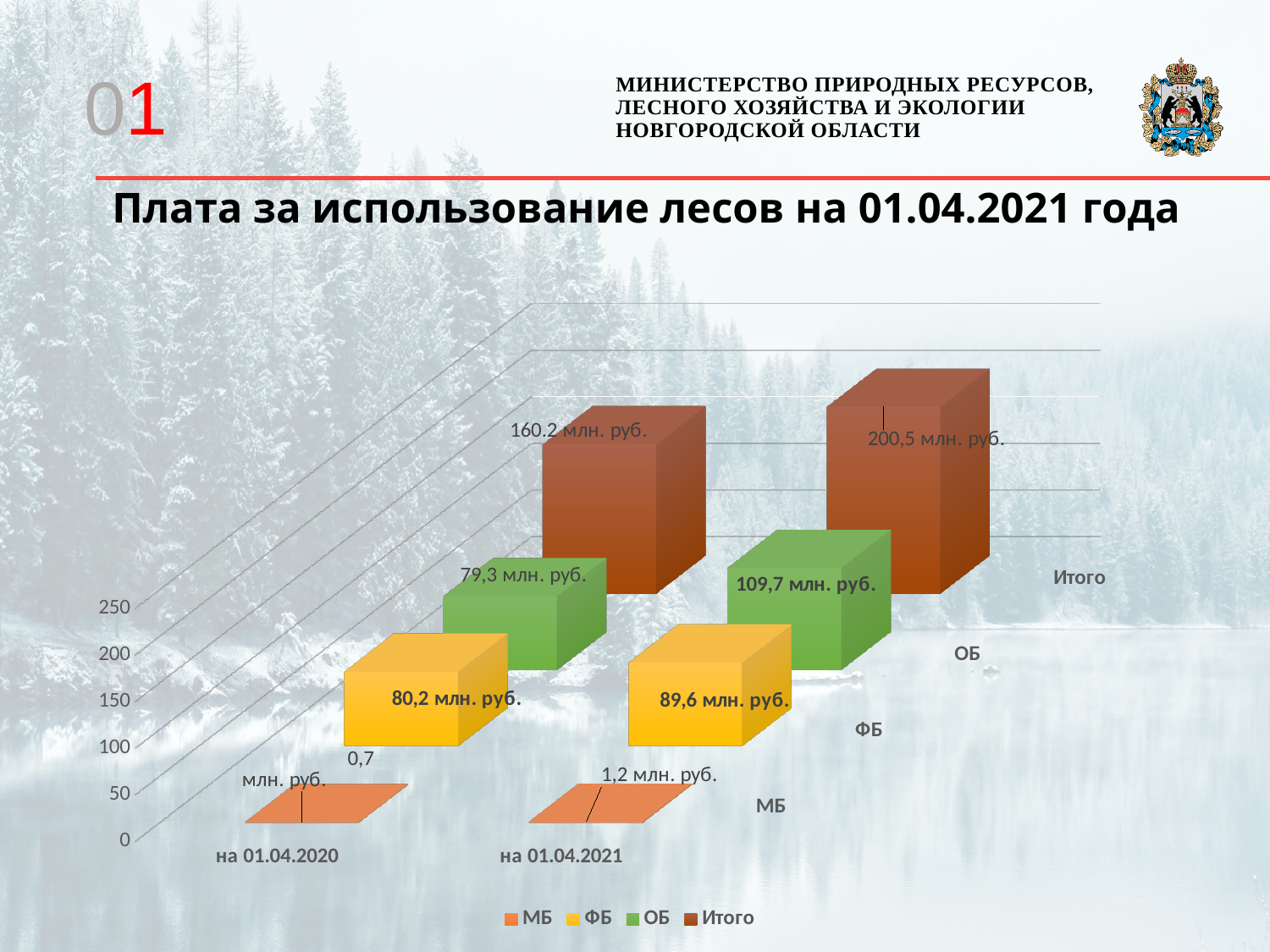
What is the value of Итого for на 01.04.2021? 200,5 млн. руб. How many series does the legend list? 4 What is the title of the chart? Плата за использование лесов на 01.04.2021 года Which series has the lowest value for на 01.04.2020? МБ Which series has the highest value for на 01.04.2021? Итого What is the value of МБ for на 01.04.2021? 1,2 млн. руб. What is the value of ОБ for на 01.04.2020? 79,3 млн. руб. Does the Итого value rise or fall from на 01.04.2020 to на 01.04.2021? rise What type of chart is shown on the slide? bar chart What is the difference between the ФБ values for на 01.04.2021 and на 01.04.2020? 9,4 млн. руб. Is the value of ОБ for на 01.04.2021 larger than the value of ОБ for на 01.04.2020? yes What is the value of ФБ for на 01.04.2021? 89,6 млн. руб.